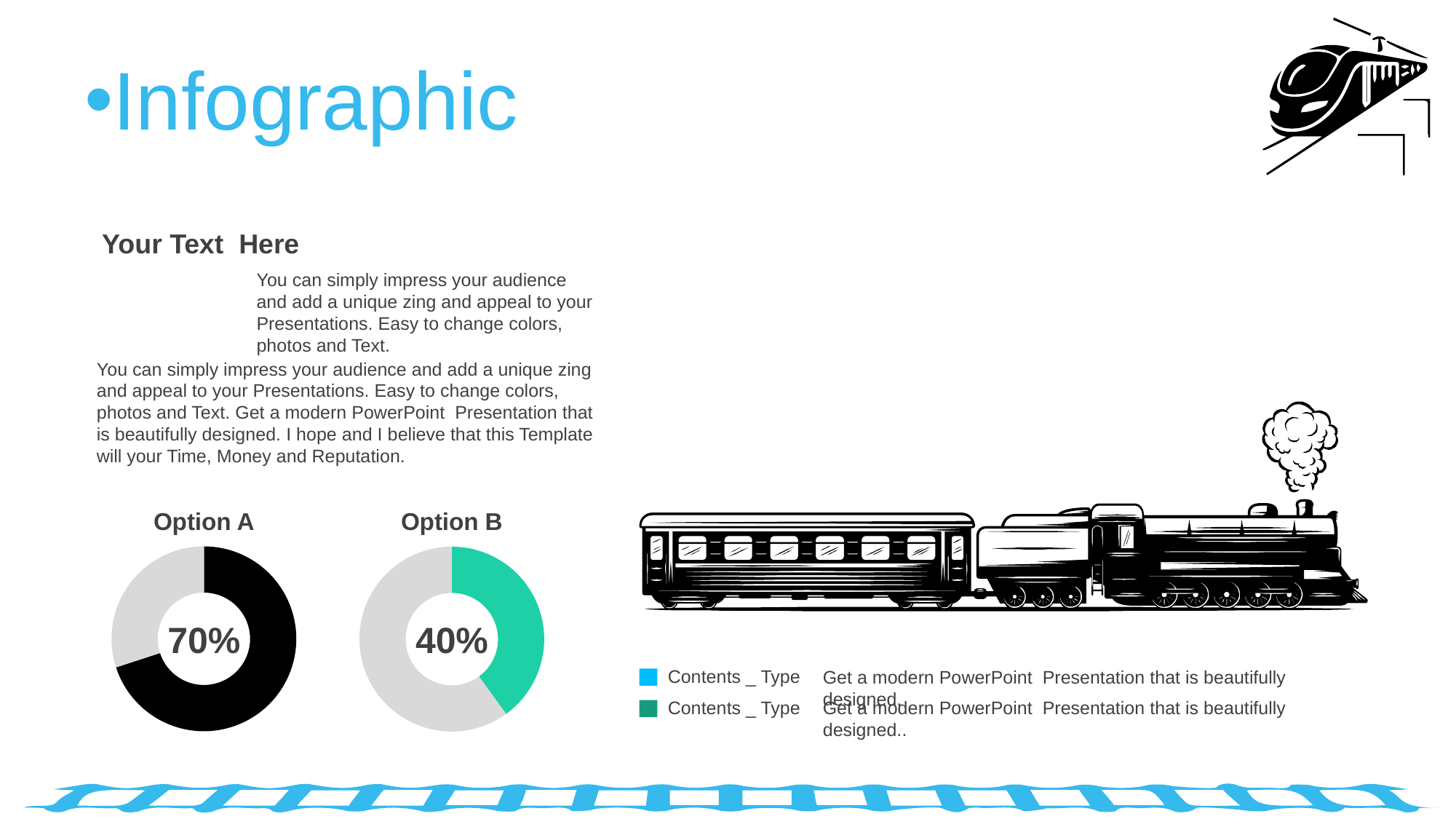
By how many percentage points does Option A exceed Option B? 30 percentage points How many donut charts are shown on the slide? 2 Which of the two donut charts shows the lowest percentage? Option B Is the value shown for Option B greater or less than 50%? less What colour is the filled portion of the Option A donut chart? Black What kind of chart is used to show Option A and Option B? Donut chart What value is shown in the centre of the Option A donut chart? 70% Which option shows the higher percentage, Option A or Option B? Option A Is the value shown for Option A greater or less than 50%? greater What colour is the filled portion of the Option B donut chart? Green Which of the two donut charts shows the highest percentage? Option A What value is shown in the centre of the Option B donut chart? 40%